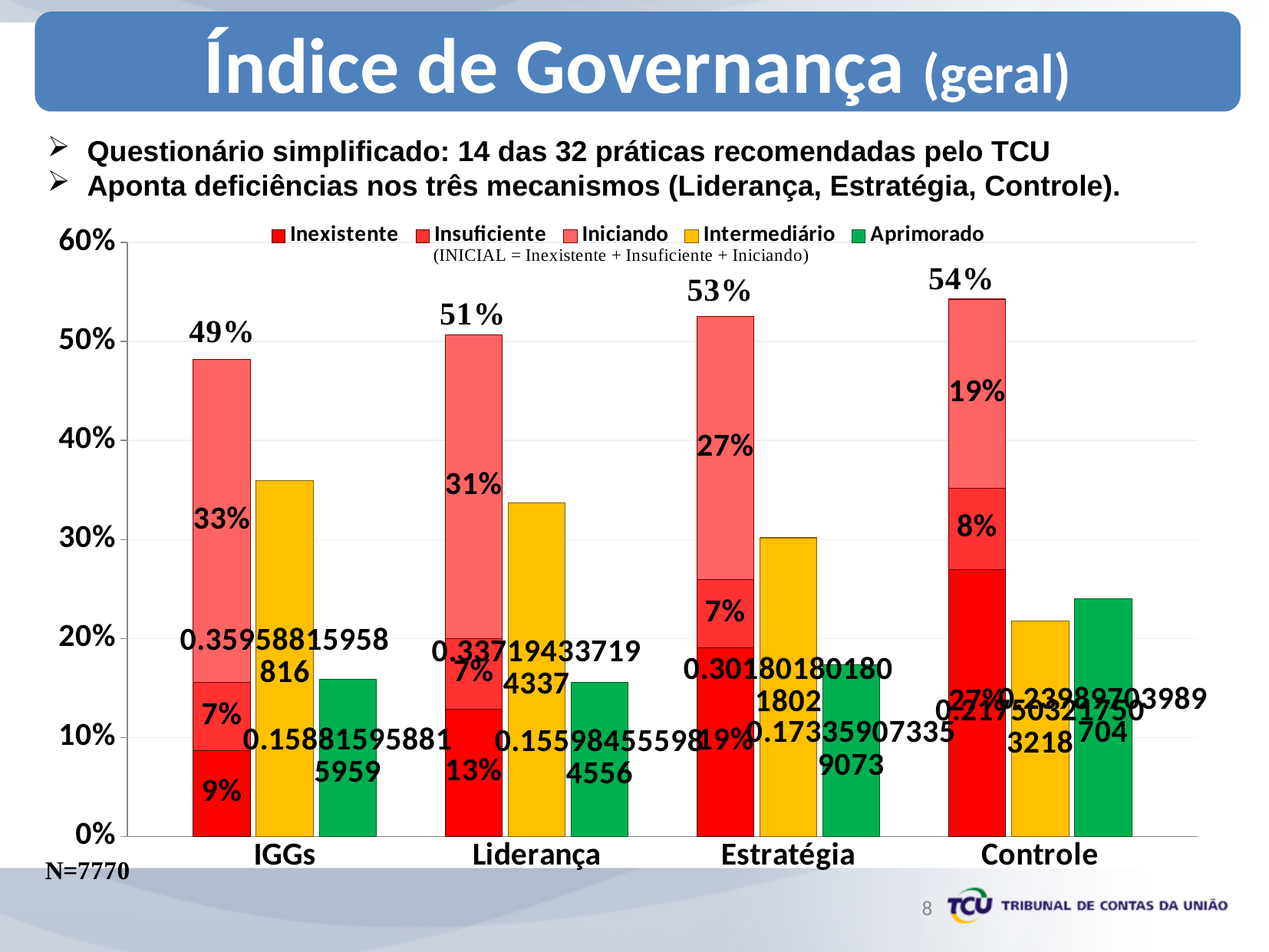
Which category has the lowest stacked INICIAL total? IGGs What is the total of the stacked red bar (INICIAL) for Estratégia? 53% What kind of chart is shown on the slide? bar chart What is the Iniciando value for IGGs? 33% What is the Insuficiente value for Controle? 8% Which is larger, the Inexistente value for Liderança or for Estratégia? Estratégia Is the Intermediário value for IGGs greater or less than 30%? greater Which category has the highest stacked INICIAL total? Controle What is the difference between the Inexistente value for Controle and the Inexistente value for IGGs? 18 percentage points What is the Inexistente value for Controle? 27% How many categories are shown on the x axis of the chart? 4 How many series does the chart legend list? 5